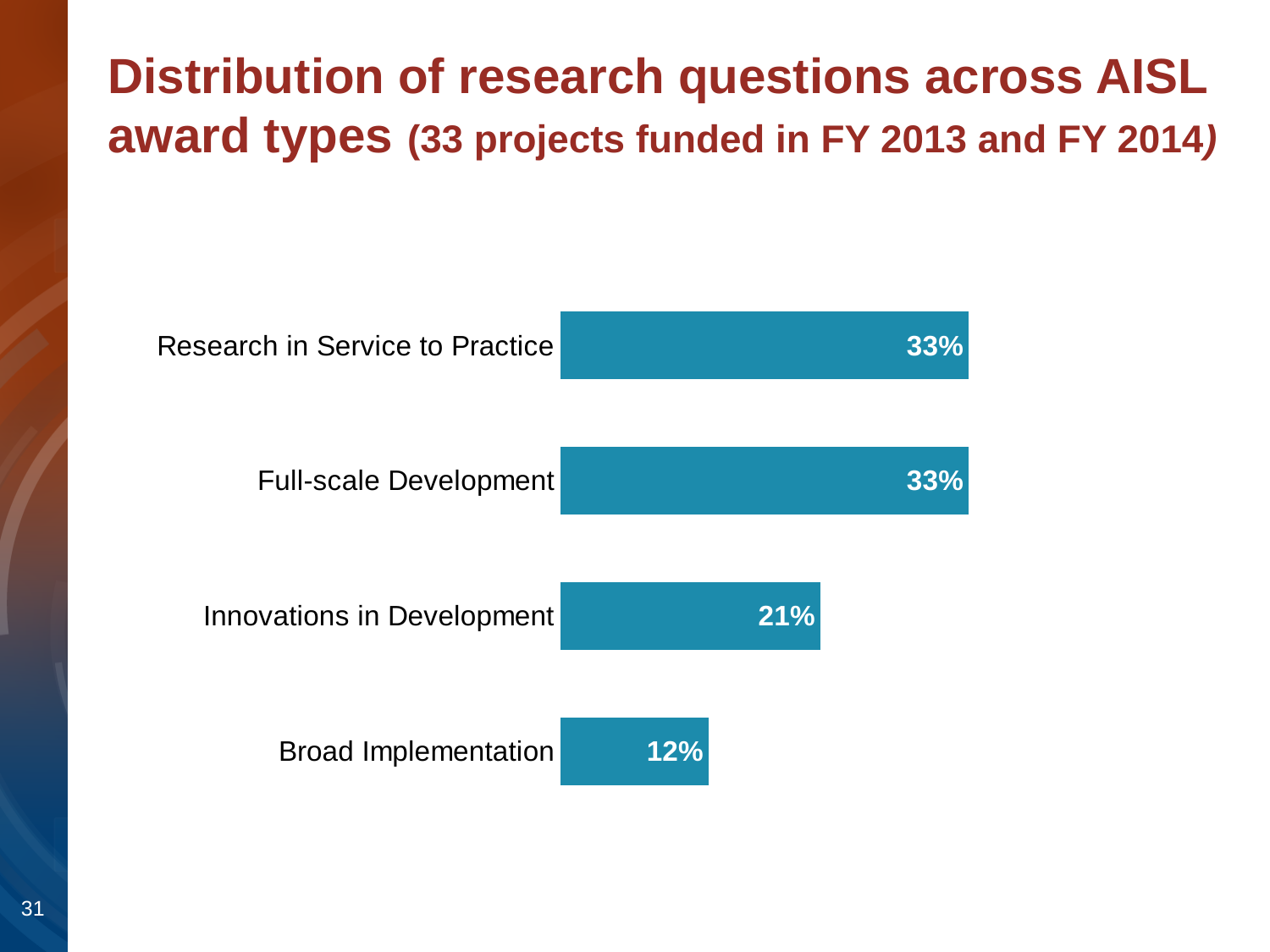
How many projects does the slide title say were funded in FY 2013 and FY 2014? 33 What is the value for Innovations in Development? 21% What is the difference between the values for Full-scale Development and Innovations in Development? 12% What is the difference between the values for Innovations in Development and Broad Implementation? 9% What is the value for Broad Implementation? 12% Which award type has the lowest value? Broad Implementation What is the value for Full-scale Development? 33% What is the value for Research in Service to Practice? 33% What kind of chart is shown on the slide? Bar chart Which is larger, the value for Innovations in Development or the value for Broad Implementation? Innovations in Development How many award types are shown in the chart? 4 Which is larger, the value for Full-scale Development or the value for Innovations in Development? Full-scale Development